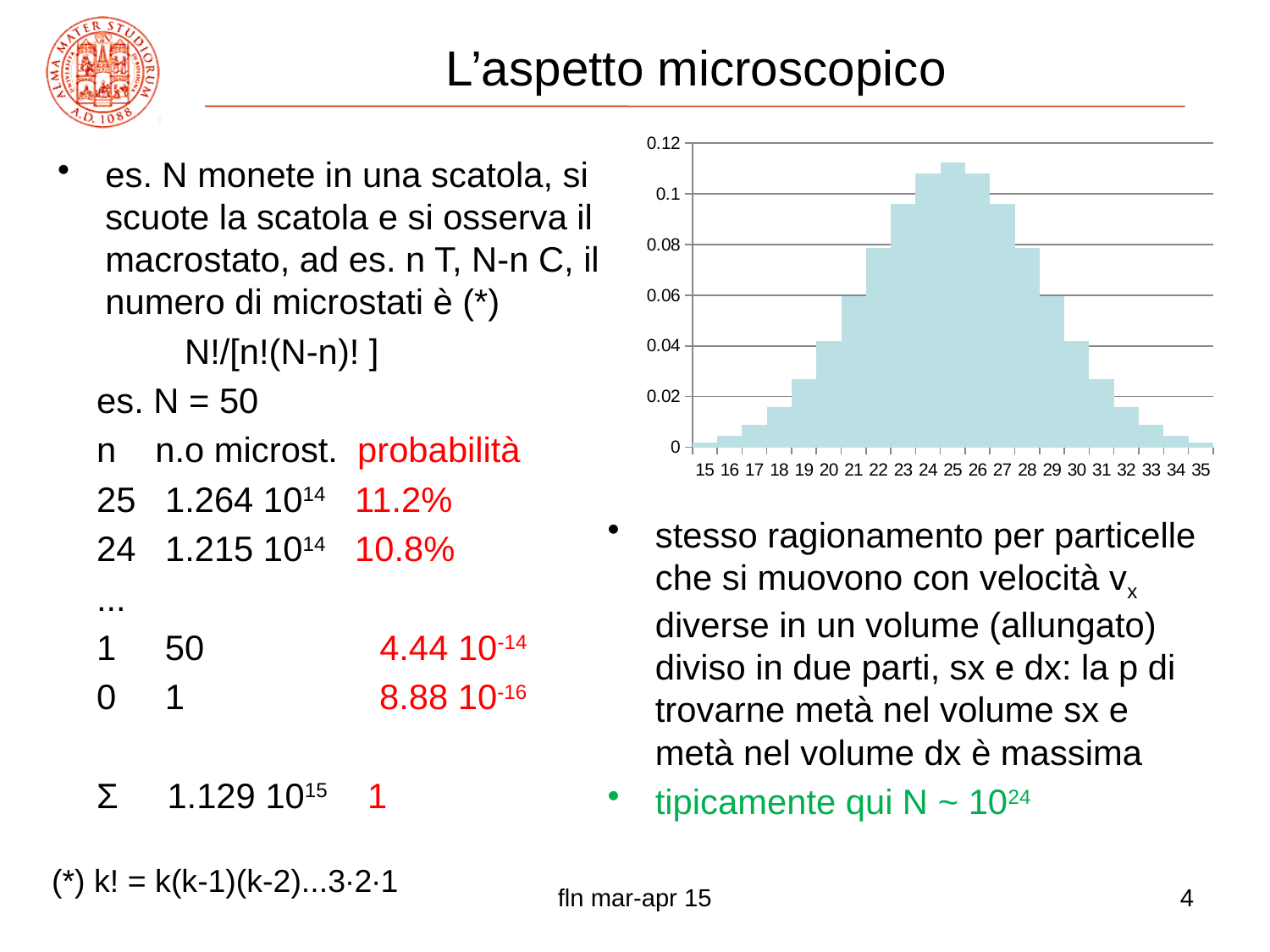
Do the values rise or fall along the x axis from 25 to 35? fall Do the values rise or fall along the x axis from 15 to 25? rise How many categories are shown on the x axis of the chart? 21 Is the value for category 20 greater or less than 0.06? less What kind of chart is shown on the slide? bar chart Is the value for category 28 greater or less than 0.06? greater Is the value for category 33 greater or less than 0.02? less Which has the larger value in the chart, category 25 or category 20? 25 What is the highest tick value shown on the y axis of the chart? 0.12 Which category on the x axis has the highest value in the chart? 25 Which has the larger value in the chart, category 23 or category 30? 23